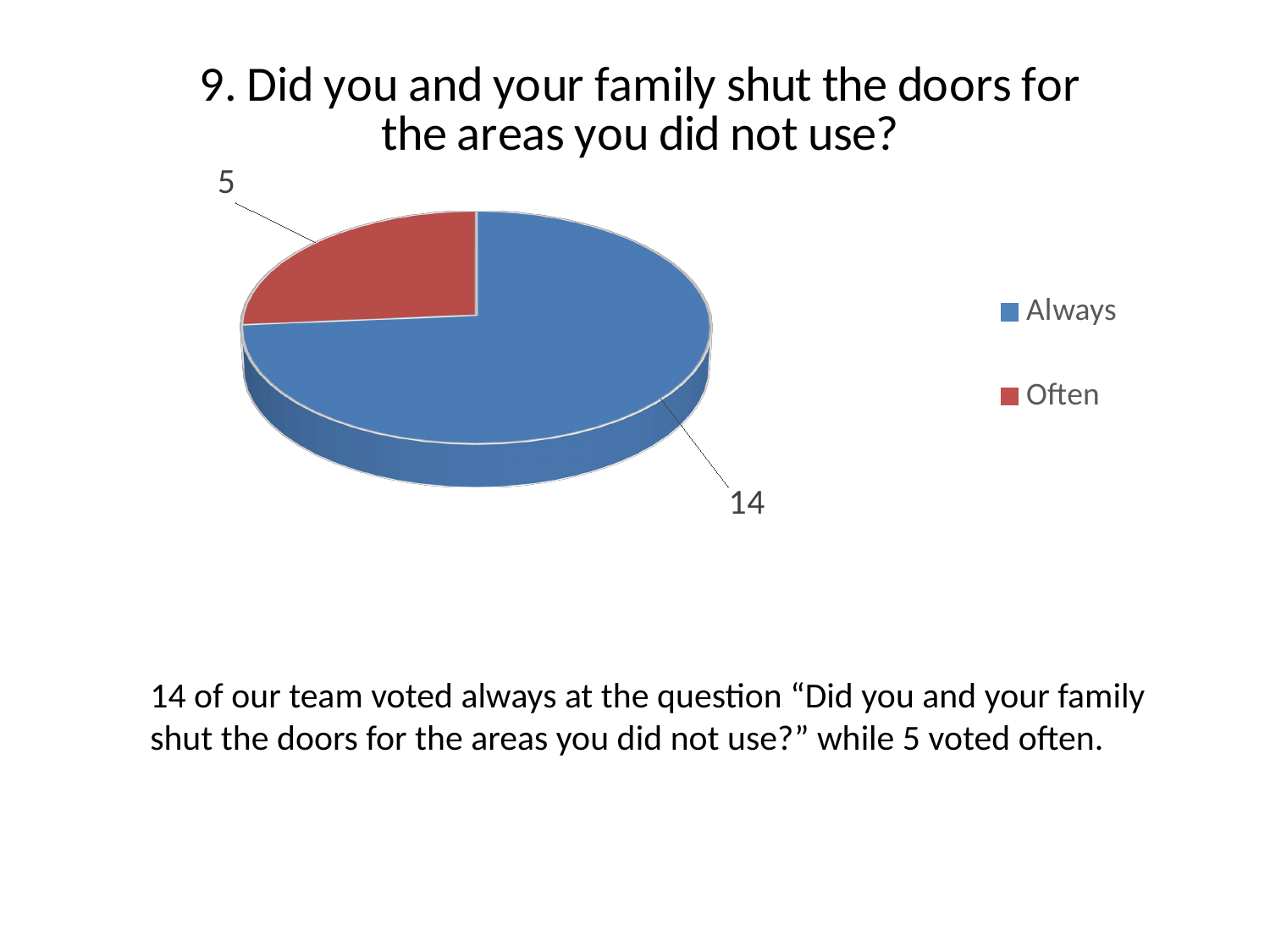
What is the value for Always? 14 Which category has the largest slice? Always How many entries does the legend list? 2 How many categories does the pie chart show? 2 What colour is the Often slice? Red What is the total of all slices in the pie chart? 19 What is the value for Often? 5 Which category has the smallest slice? Often What is the title of the chart? 9. Did you and your family shut the doors for the areas you did not use? Which is larger, the value for Always or the value for Often? Always What is the difference between the values for Always and Often? 9 What kind of chart is shown on the slide? Pie chart